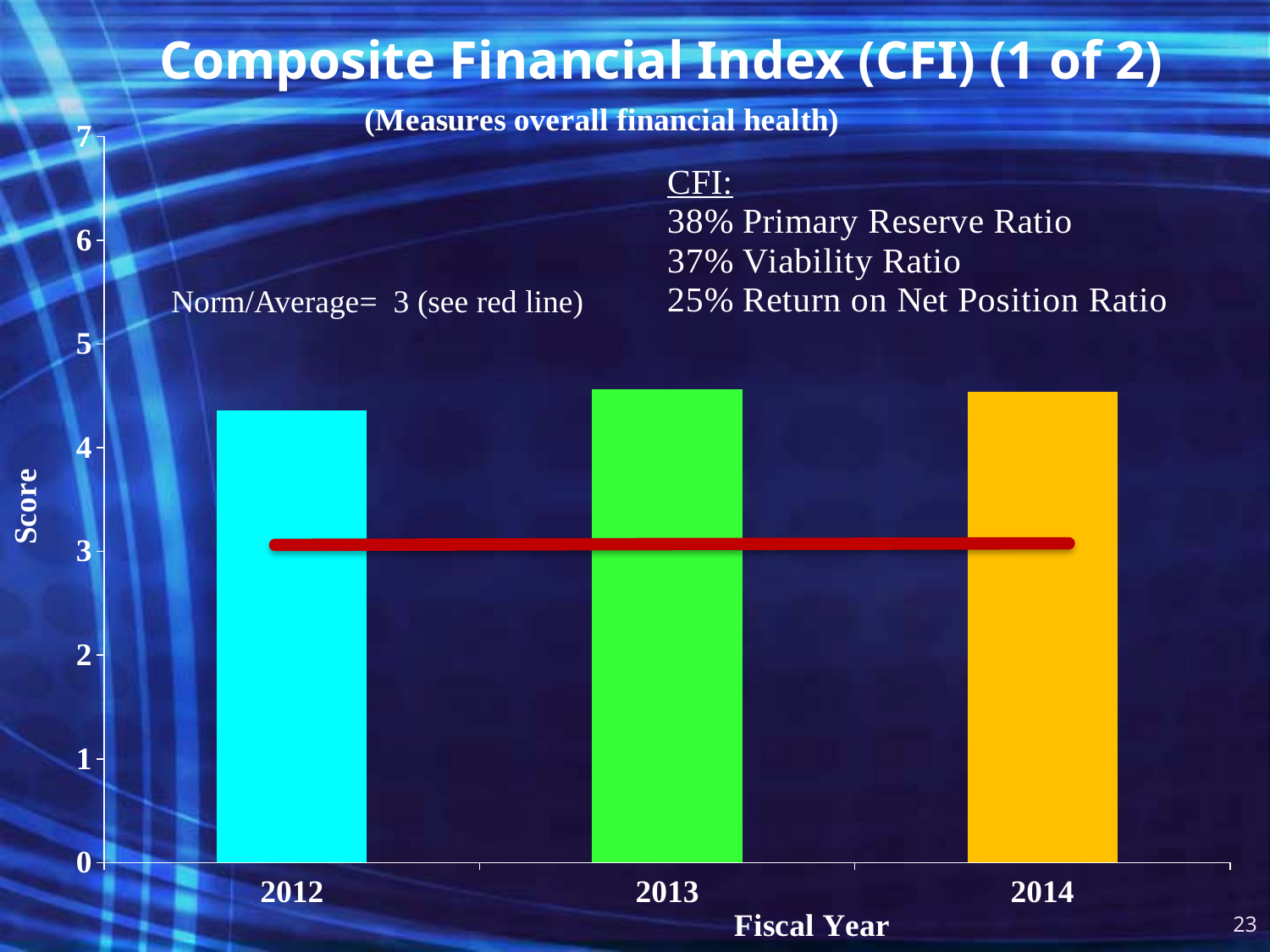
Is the value for 2014 greater or less than 5? less What value does the red line in the chart represent? 3 What is the label of the y axis? Score What kind of chart is shown on the slide? bar chart Is the value for 2014 greater or less than 3? greater What is the label of the x axis? Fiscal Year Is the value for 2012 greater or less than 4? greater Which has the larger value, 2012 or 2013? 2013 How many fiscal years are plotted as bars in the chart? 3